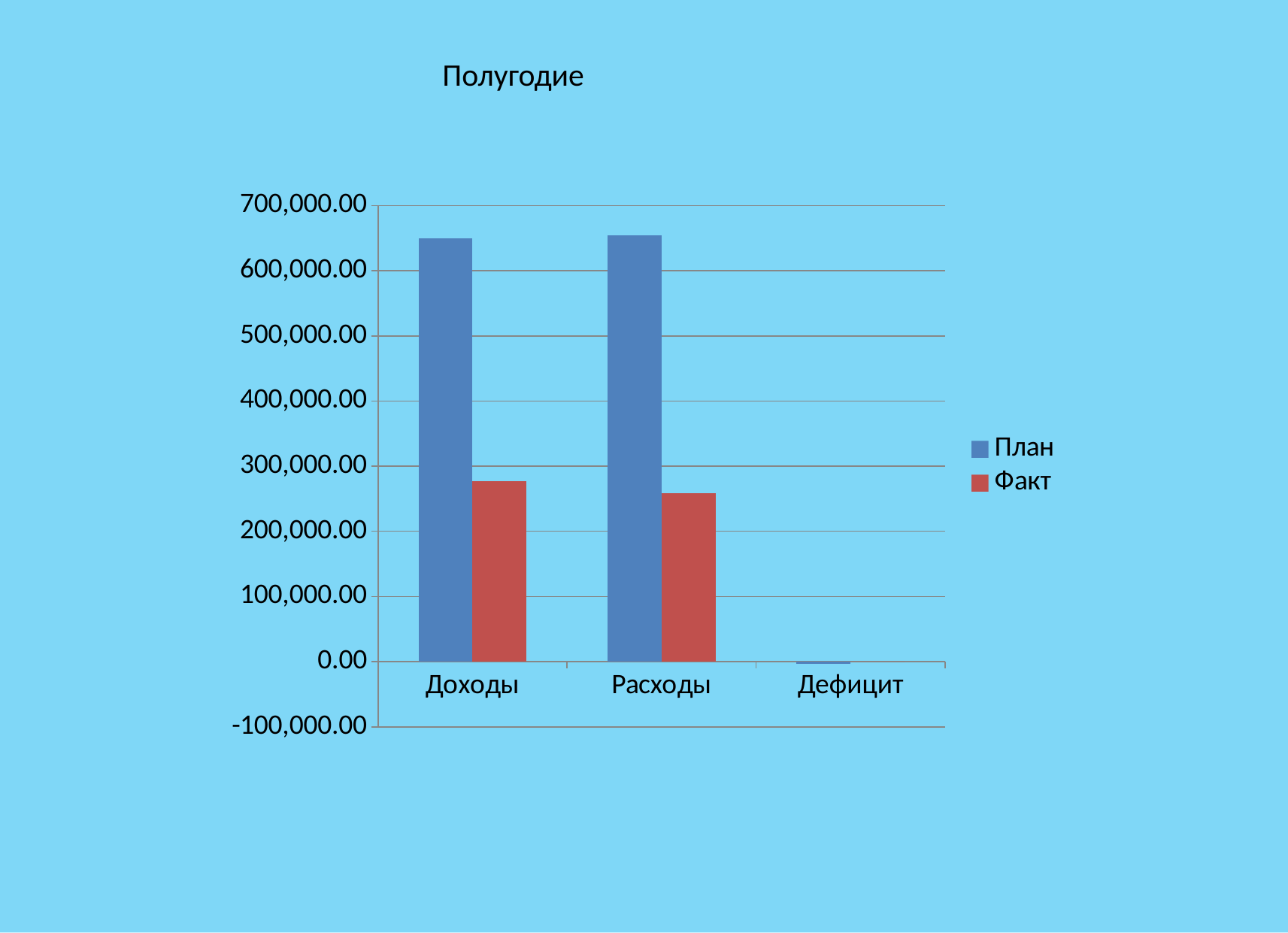
How many series does the legend list? 2 Which category has the lowest План value? Дефицит Is the Факт value for Расходы greater or less than 200,000.00? greater Is the План value for Расходы greater or less than 700,000.00? less How many categories are shown on the x axis? 3 Is the Факт value for Доходы greater or less than 300,000.00? less What is the title of the chart? Полугодие What kind of chart is shown on the slide? bar chart For Доходы, which is larger: the План value or the Факт value? План Which series are listed in the legend? План, Факт Which category has the lowest Факт value? Дефицит